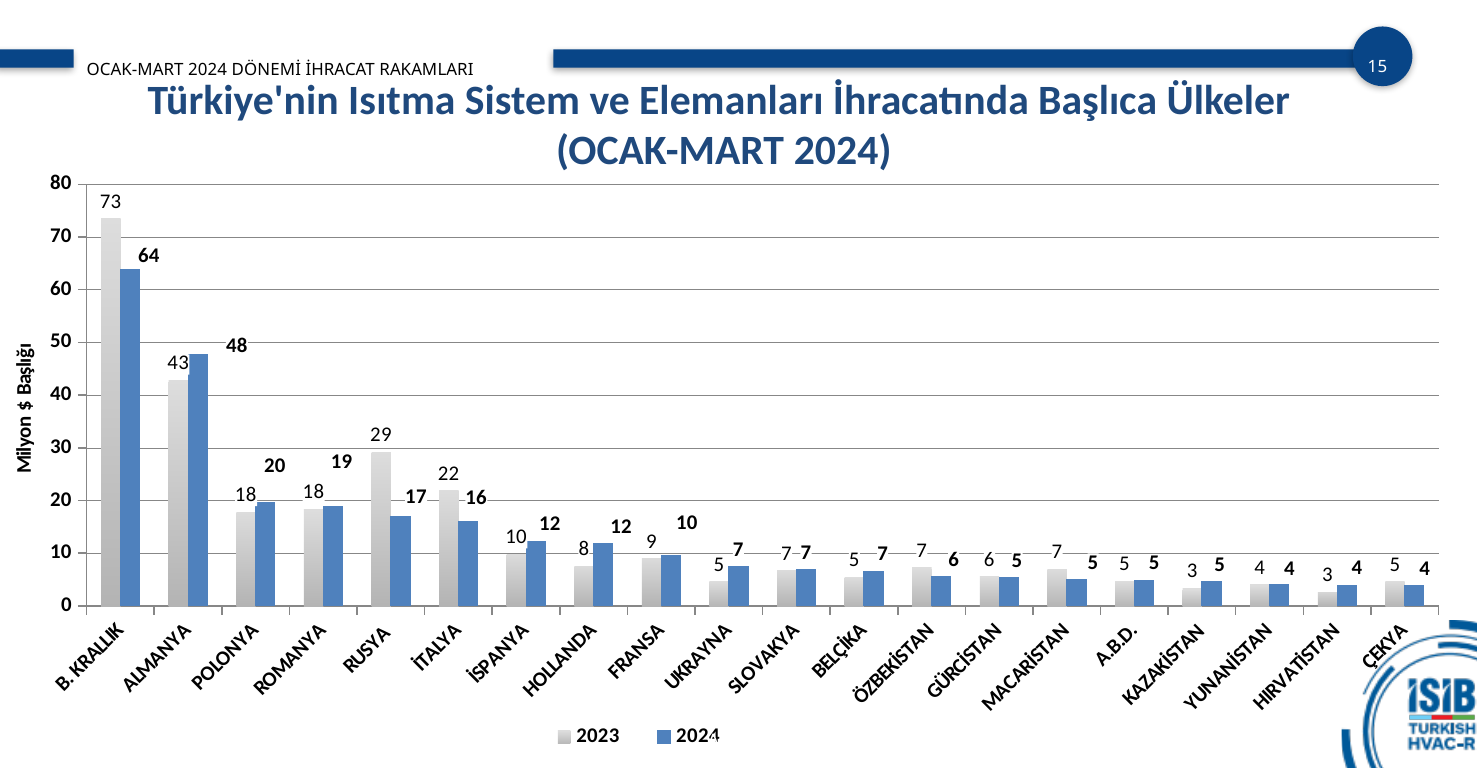
What is the difference between the 2023 and 2024 values for RUSYA? 12 What is the 2024 value for B. KRALLIK? 64 What kind of chart is shown on the slide? Bar chart What is the 2024 value for ALMANYA? 48 Which is larger for ALMANYA, the 2023 value or the 2024 value? 2024 Which is larger for İTALYA, the 2023 value or the 2024 value? 2023 How many series does the legend list? 2 How many countries are shown on the x axis? 20 What is the difference between the 2023 and 2024 values for B. KRALLIK? 9 What is the 2023 value for RUSYA? 29 Which country has the highest 2023 value? B. KRALLIK What is the label of the y axis? Milyon $ Başlığı